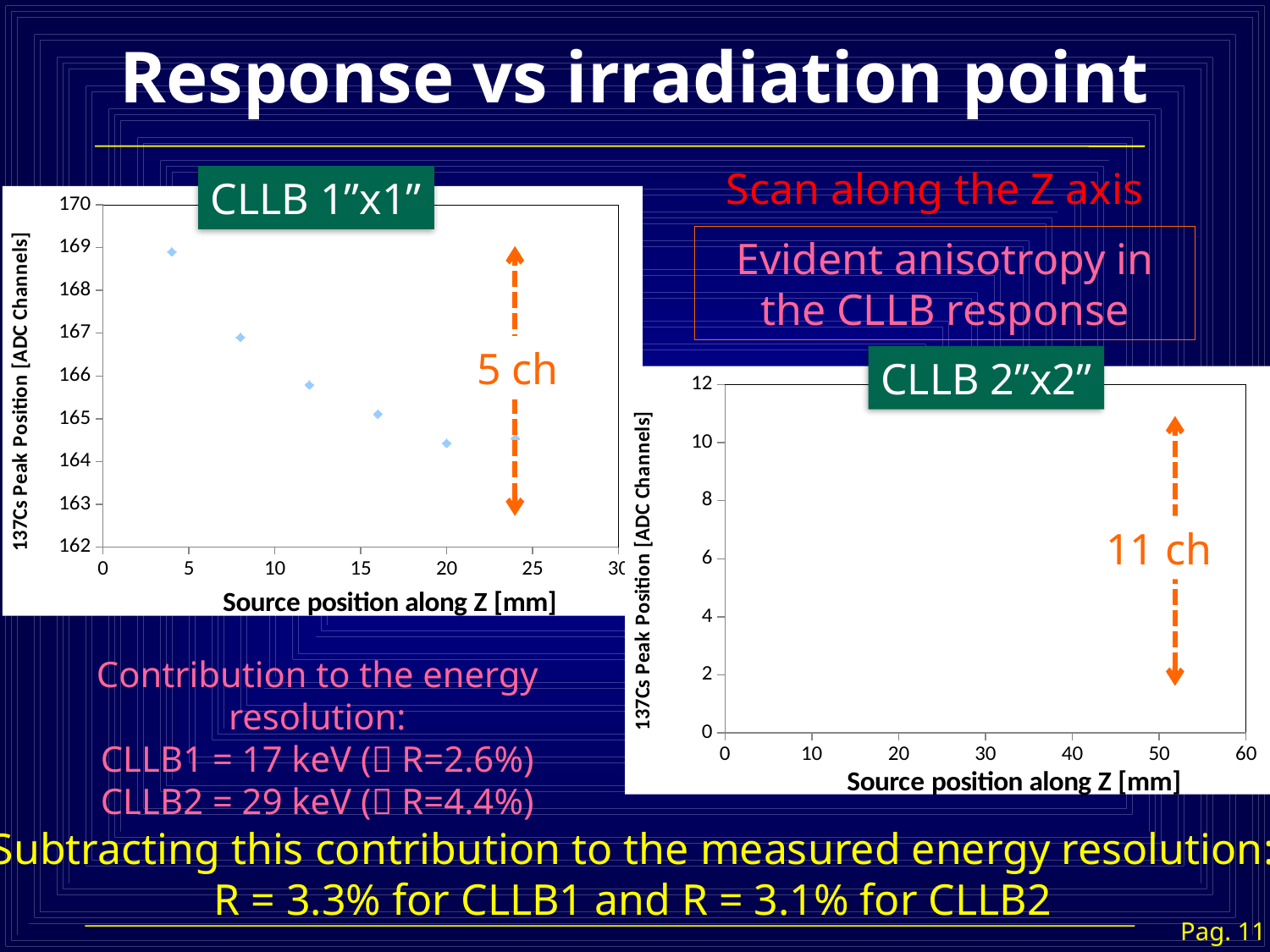
In the CLLB 1"x1" chart, is the 137Cs peak position at 12 mm greater or less than 165? greater What kind of chart is the CLLB 1"x1" chart on the left? scatter chart In the CLLB 1"x1" chart, which has the larger 137Cs peak position: the point at 4 mm or the point at 20 mm? 4 mm In the CLLB 1"x1" chart, at which source position is the 137Cs peak position highest? 4 mm In the CLLB 1"x1" chart, is the 137Cs peak position at 4 mm greater or less than 168? greater What is the x-axis label of the CLLB 1"x1" chart? Source position along Z [mm] In the CLLB 1"x1" chart, is the 137Cs peak position at 20 mm greater or less than 165? less What is the maximum value shown on the x-axis of the CLLB 2"x2" chart? 60 In the CLLB 1"x1" chart, do the 137Cs peak position values rise or fall as the source position along Z increases? fall What is the y-axis label of the CLLB 2"x2" chart on the right? 137Cs Peak Position [ADC Channels] What is the maximum value shown on the y-axis of the CLLB 2"x2" chart? 12